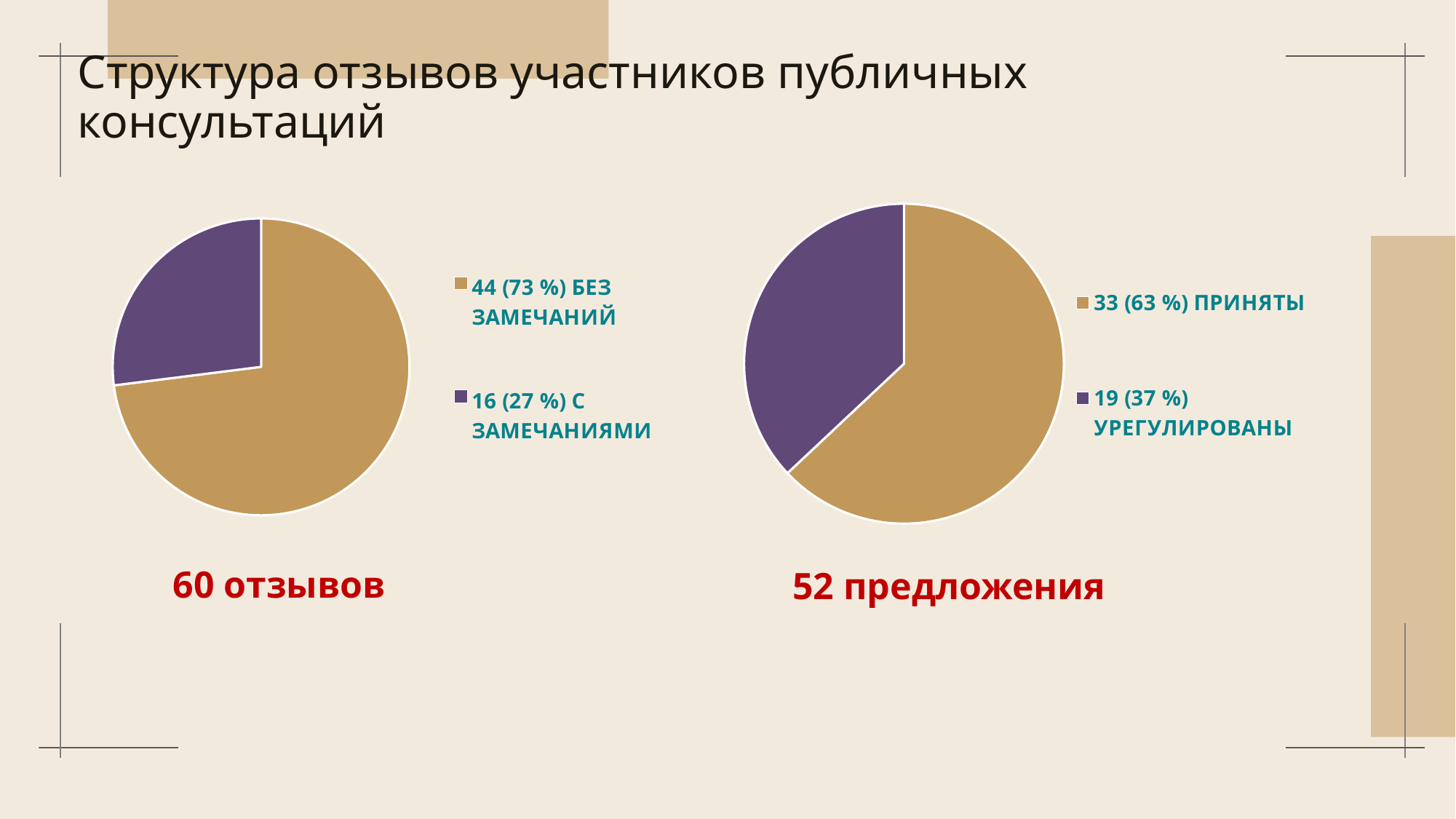
How many entries does the legend of the right chart (52 предложения) list? 2 In the left chart (60 отзывов), how many reviews are БЕЗ ЗАМЕЧАНИЙ according to the legend? 44 In the right chart (52 предложения), what is the difference between the number of proposals ПРИНЯТЫ and УРЕГУЛИРОВАНЫ? 14 In the right chart (52 предложения), which slice is the smallest? УРЕГУЛИРОВАНЫ In the right chart (52 предложения), what share of the pie is УРЕГУЛИРОВАНЫ? 37 % How many slices does the left chart (60 отзывов) have? 2 In the left chart (60 отзывов), which slice is larger: БЕЗ ЗАМЕЧАНИЙ or С ЗАМЕЧАНИЯМИ? БЕЗ ЗАМЕЧАНИЙ What kind of chart is the left chart (60 отзывов)? pie chart In the left chart (60 отзывов), what share of the pie is С ЗАМЕЧАНИЯМИ? 27 % In the right chart (52 предложения), how many proposals are ПРИНЯТЫ according to the legend? 33 What colour is the ПРИНЯТЫ slice in the right chart (52 предложения)? tan (gold-brown) In the left chart (60 отзывов), what is the difference between the number of reviews БЕЗ ЗАМЕЧАНИЙ and С ЗАМЕЧАНИЯМИ? 28